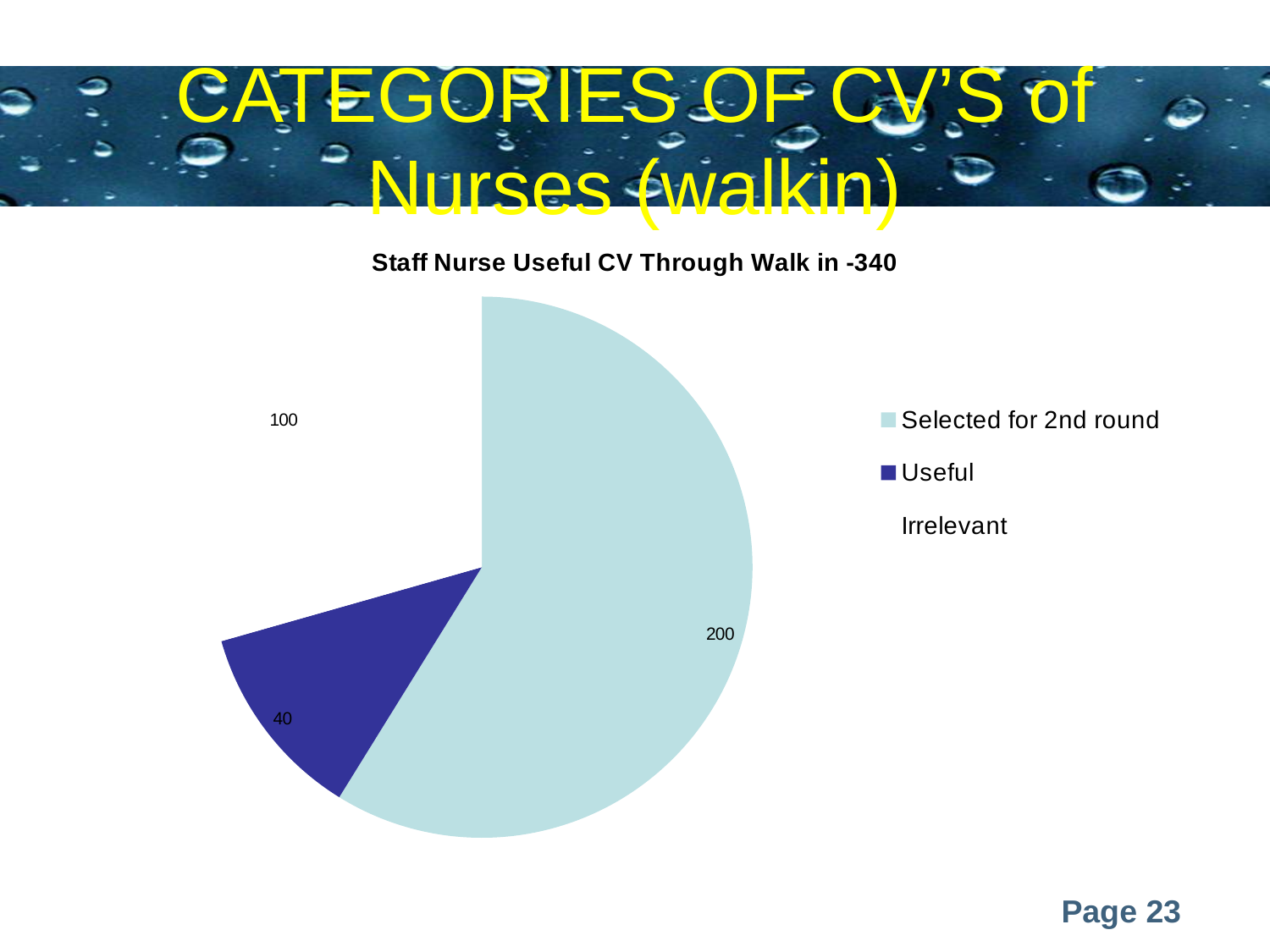
What is the title of the chart? Staff Nurse Useful CV Through Walk in -340 What is the total of all the slices in the pie? 340 What is the value for Irrelevant? 100 Which category has the largest slice of the pie? Selected for 2nd round Which is larger, the value for Irrelevant or the value for Useful? Irrelevant Which category has the smallest slice of the pie? Useful What is the difference between the values for Selected for 2nd round and Irrelevant? 100 How many categories does the legend list? 3 What is the value for Selected for 2nd round? 200 What type of chart is shown on the slide? Pie chart What is the difference between the values for Irrelevant and Useful? 60 What is the value for Useful? 40